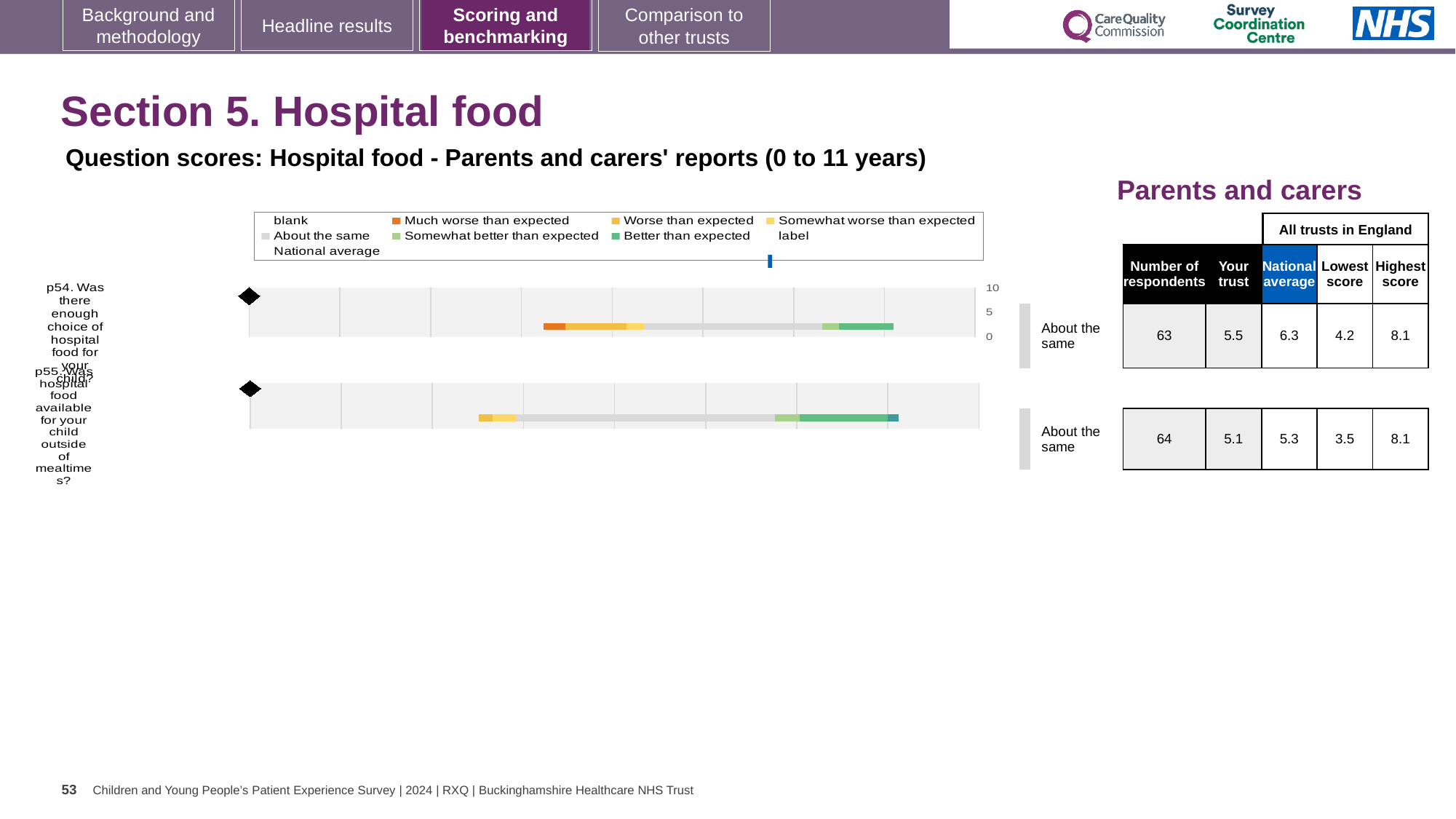
Is the 'Your trust' score for p54 greater or less than 5? greater How many survey questions are plotted in the chart? 2 What is the lowest score across all trusts in England for p55? 3.5 What benchmark category is shown for p54 and p55? About the same What is the 'Your trust' score for p55 (hospital food available outside of mealtimes)? 5.1 What is the 'Your trust' score for p54 (enough choice of hospital food)? 5.5 How many respondents answered p55? 64 What is the national average score for p54? 6.3 How much higher is the national average than the trust's score for p55? 0.2 What kind of chart is shown on the slide? bar chart Which question has the higher 'Your trust' score, p54 or p55? p54 What is the difference between the highest and lowest scores across all trusts for p54? 3.9